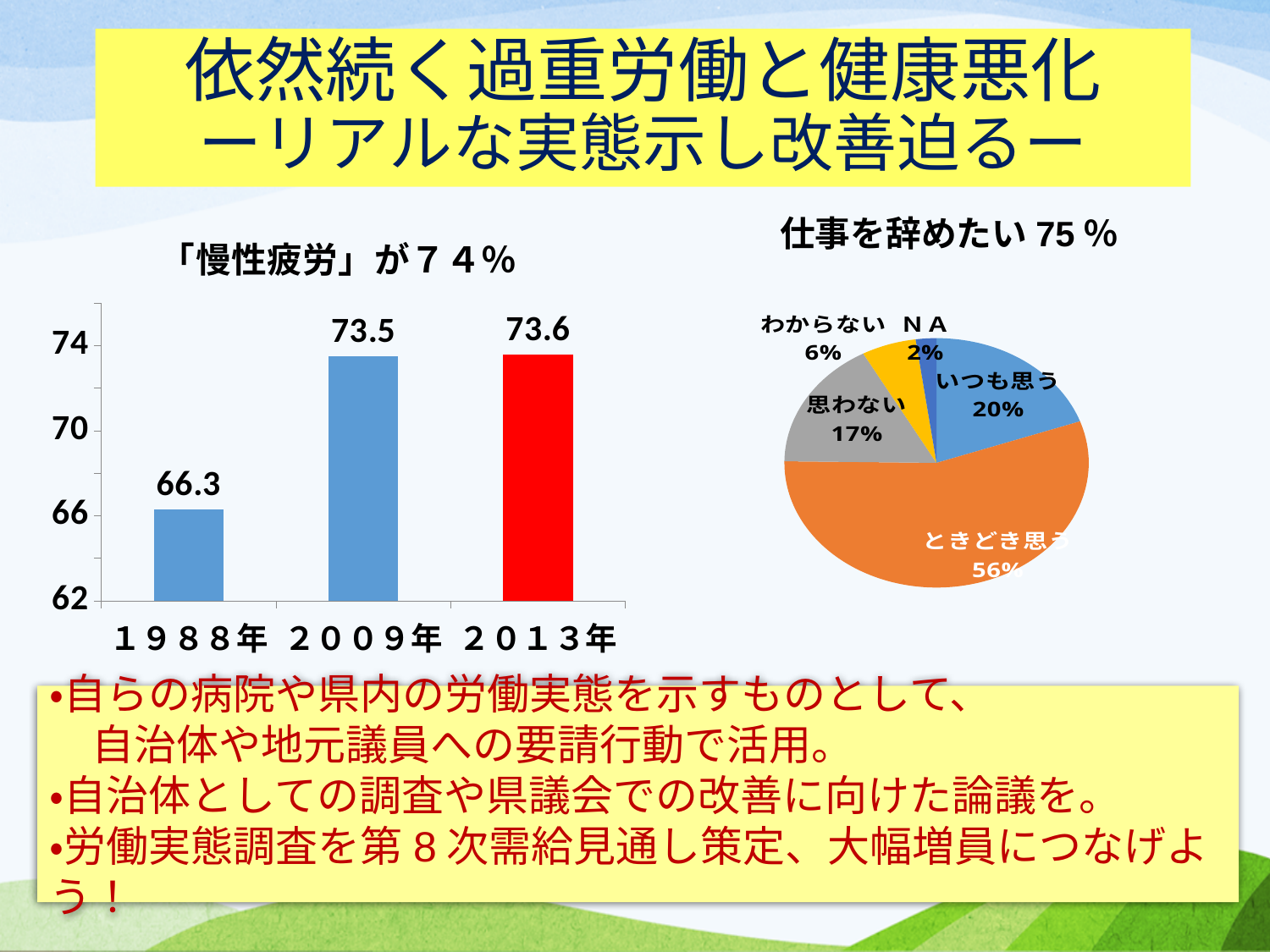
What kind of chart is the one on the left titled 「慢性疲労」が７４％? bar chart In the bar chart titled 「慢性疲労」が７４％, what is the value for 2009年? 73.5 In the pie chart titled 仕事を辞めたい75％, how many slices are there? 5 In the bar chart titled 「慢性疲労」が７４％, which year has the lowest value? 1988年 In the bar chart titled 「慢性疲労」が７４％, what is the value for 2013年? 73.6 In the bar chart titled 「慢性疲労」が７４％, do the values rise or fall from 1988年 to 2013年? rise In the pie chart titled 仕事を辞めたい75％, what share is 思わない? 17% In the bar chart titled 「慢性疲労」が７４％, how many years are shown? 3 In the pie chart titled 仕事を辞めたい75％, what share is ときどき思う? 56% In the bar chart titled 「慢性疲労」が７４％, what is the value for 1988年? 66.3 In the pie chart titled 仕事を辞めたい75％, which slice is the smallest? ＮＡ In the bar chart titled 「慢性疲労」が７４％, what is the difference between the values for 2009年 and 1988年? 7.2